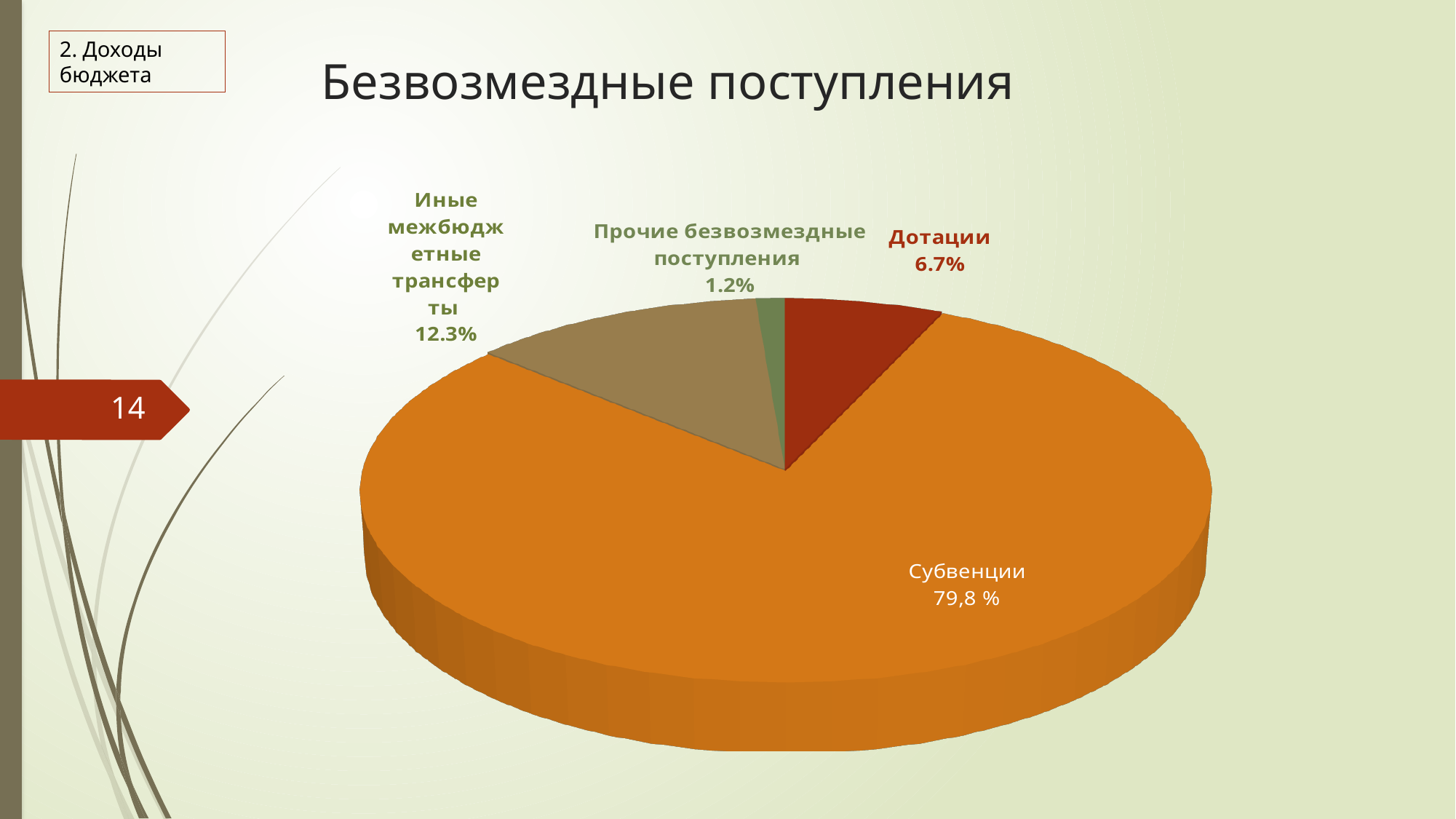
How many slices does the pie chart have? 4 What is the difference between the values for Иные межбюджетные трансферты and Дотации? 5.6% Which category has the smallest slice of the pie? Прочие безвозмездные поступления What is the value shown for Иные межбюджетные трансферты? 12.3% What is the value shown for Прочие безвозмездные поступления? 1.2% What share of the pie is labelled for Субвенции? 79,8 % What type of chart is shown on the slide? Pie chart What is the title of the chart on the slide? Безвозмездные поступления Which category has the largest slice of the pie? Субвенции What colour is the Субвенции slice? Orange What is the value shown for Дотации? 6.7% Which is larger, Дотации or Иные межбюджетные трансферты? Иные межбюджетные трансферты